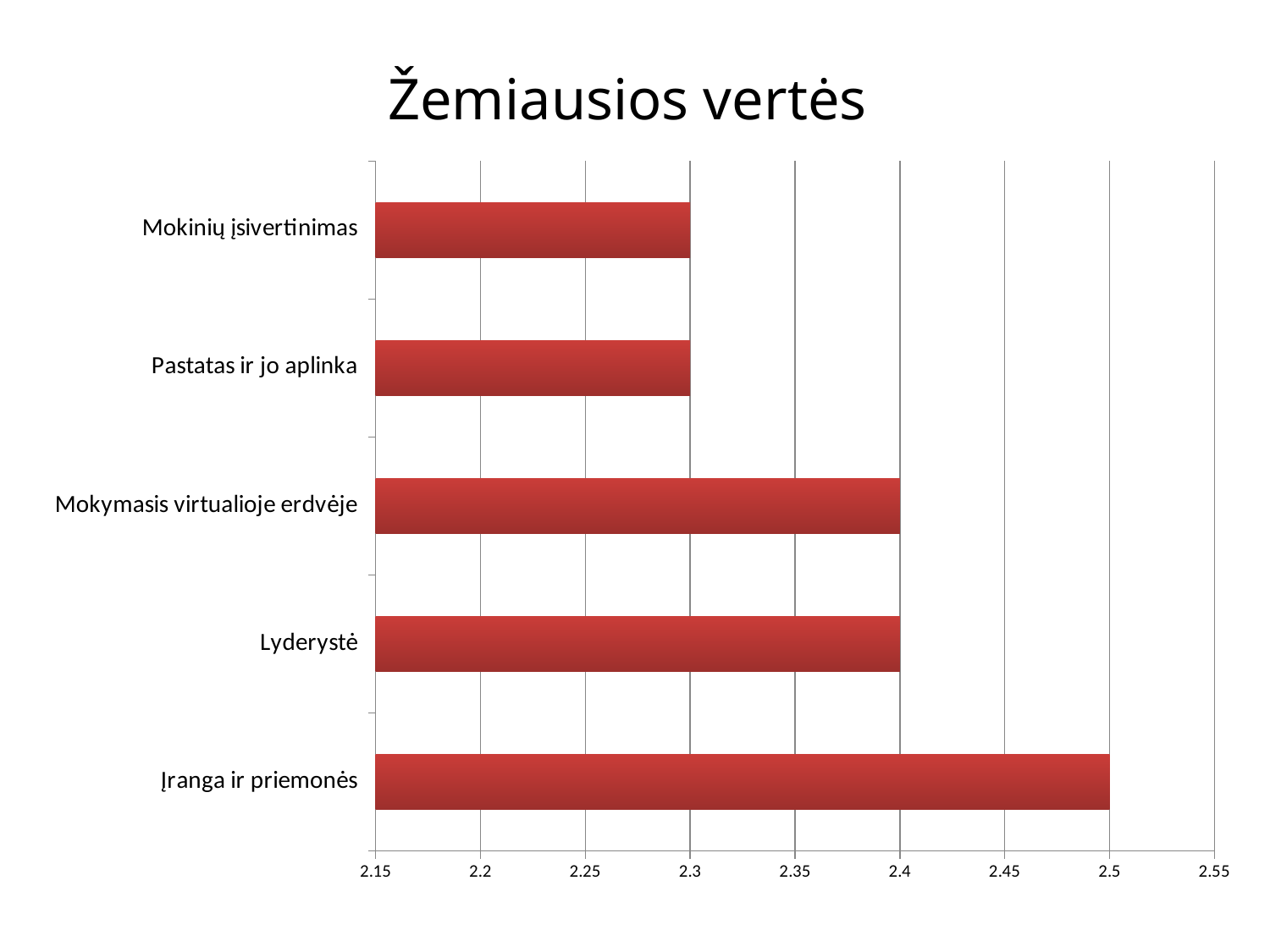
What is the value for Lyderystė? 2.4 What is the value for Mokymasis virtualioje erdvėje? 2.4 Is the value for Įranga ir priemonės greater or less than 2.45? greater What kind of chart is shown on the slide? bar chart What is the value for Įranga ir priemonės? 2.5 What is the difference between the values for Lyderystė and Mokinių įsivertinimas? 0.1 What is the difference between the values for Įranga ir priemonės and Pastatas ir jo aplinka? 0.2 What is the title of the chart? Žemiausios vertės What is the value for Mokinių įsivertinimas? 2.3 Which is larger, the value for Lyderystė or the value for Pastatas ir jo aplinka? Lyderystė How many categories are shown in the chart? 5 Which category has the highest value? Įranga ir priemonės